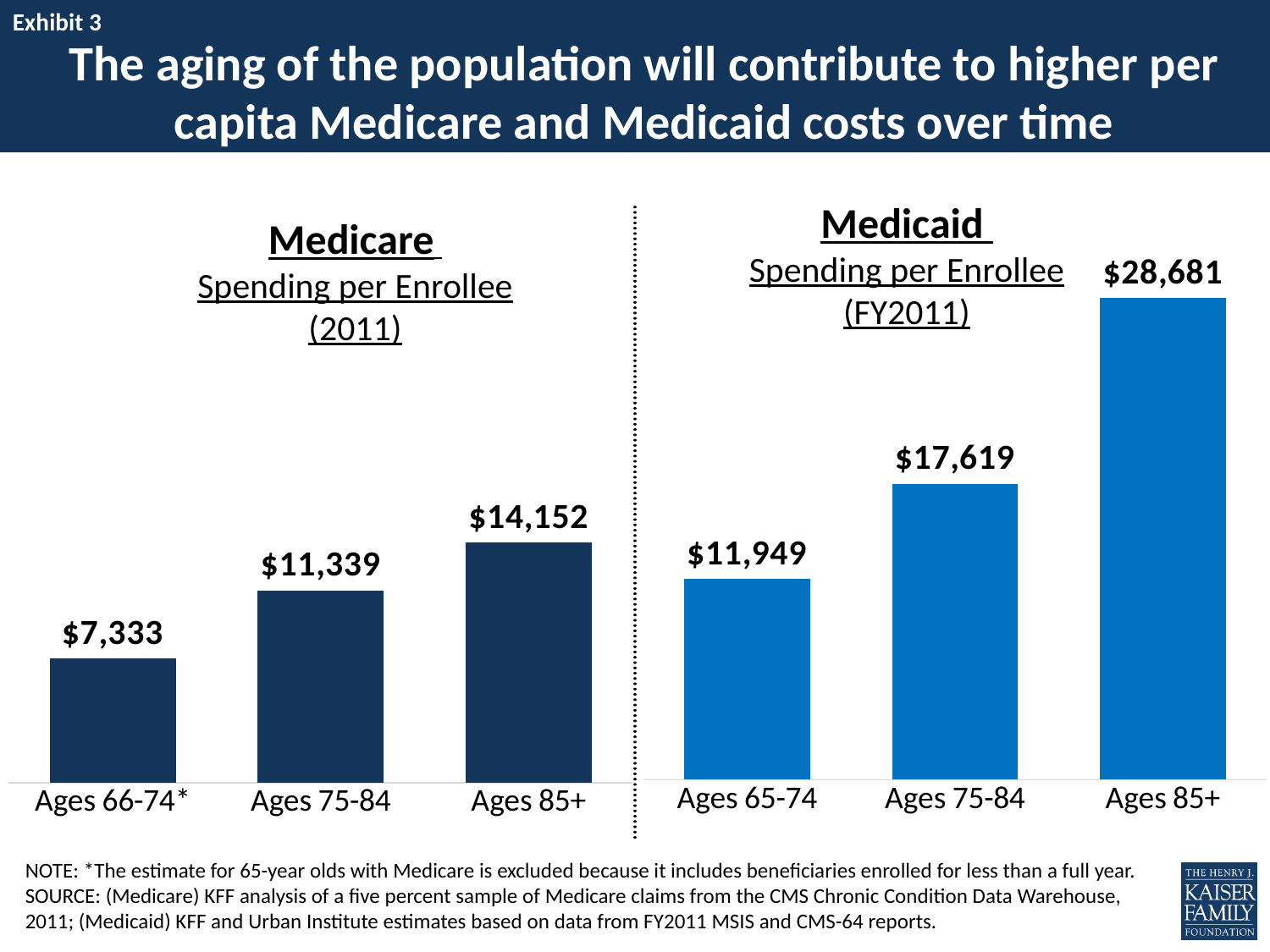
How many age groups are shown in the Medicare Spending per Enrollee (2011) chart? 3 In the Medicaid Spending per Enrollee (FY2011) chart, which age group has the highest spending? Ages 85+ What type of chart is the Medicaid Spending per Enrollee (FY2011) chart? Bar chart In the Medicare Spending per Enrollee (2011) chart, what is the difference between Ages 85+ and Ages 75-84? $2,813 In the Medicaid Spending per Enrollee (FY2011) chart, what is the value for Ages 65-74? $11,949 In the Medicaid Spending per Enrollee (FY2011) chart, what is the difference between Ages 85+ and Ages 65-74? $16,732 In the Medicare Spending per Enrollee (2011) chart, what is the value for Ages 66-74*? $7,333 In the Medicaid Spending per Enrollee (FY2011) chart, what is the value for Ages 75-84? $17,619 In the Medicaid Spending per Enrollee (FY2011) chart, do values rise or fall as age increases along the x axis? Rise In the Medicare Spending per Enrollee (2011) chart, what is the value for Ages 85+? $14,152 In the Medicare Spending per Enrollee (2011) chart, which age group has the lowest spending? Ages 66-74* Which is larger: Medicare spending per enrollee for Ages 85+ or Medicaid spending per enrollee for Ages 75-84? Medicaid Ages 75-84